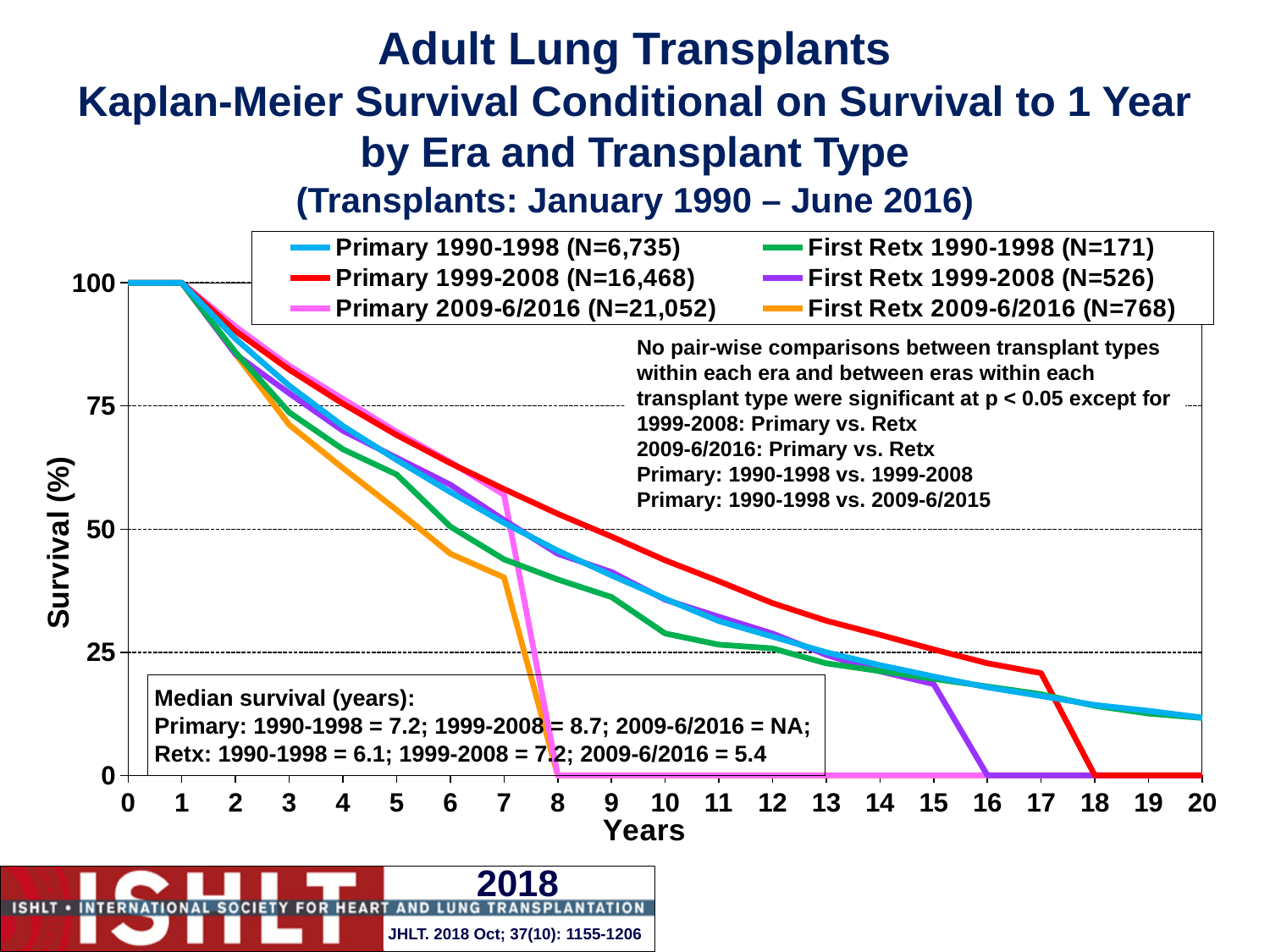
Do the survival curves rise or fall as years increase along the x axis? fall According to the text box, what is the median survival in years for Primary 2009-6/2016? NA What kind of chart is shown on the slide? line chart Is the survival for Primary 1999-2008 at year 5 greater or less than 50? greater Is the survival for First Retx 2009-6/2016 at year 7 greater or less than 50? less How many series does the legend list? 6 Which series has the highest survival at year 10? Primary 1999-2008 What is the N shown in the legend for Primary 1999-2008? 16,468 According to the text box, what is the median survival in years for Primary 1999-2008? 8.7 At year 15, which has higher survival: Primary 1999-2008 or Primary 1990-1998? Primary 1999-2008 Which series has the lowest survival at year 5? First Retx 2009-6/2016 According to the text box, what is the median survival in years for Retx 2009-6/2016? 5.4